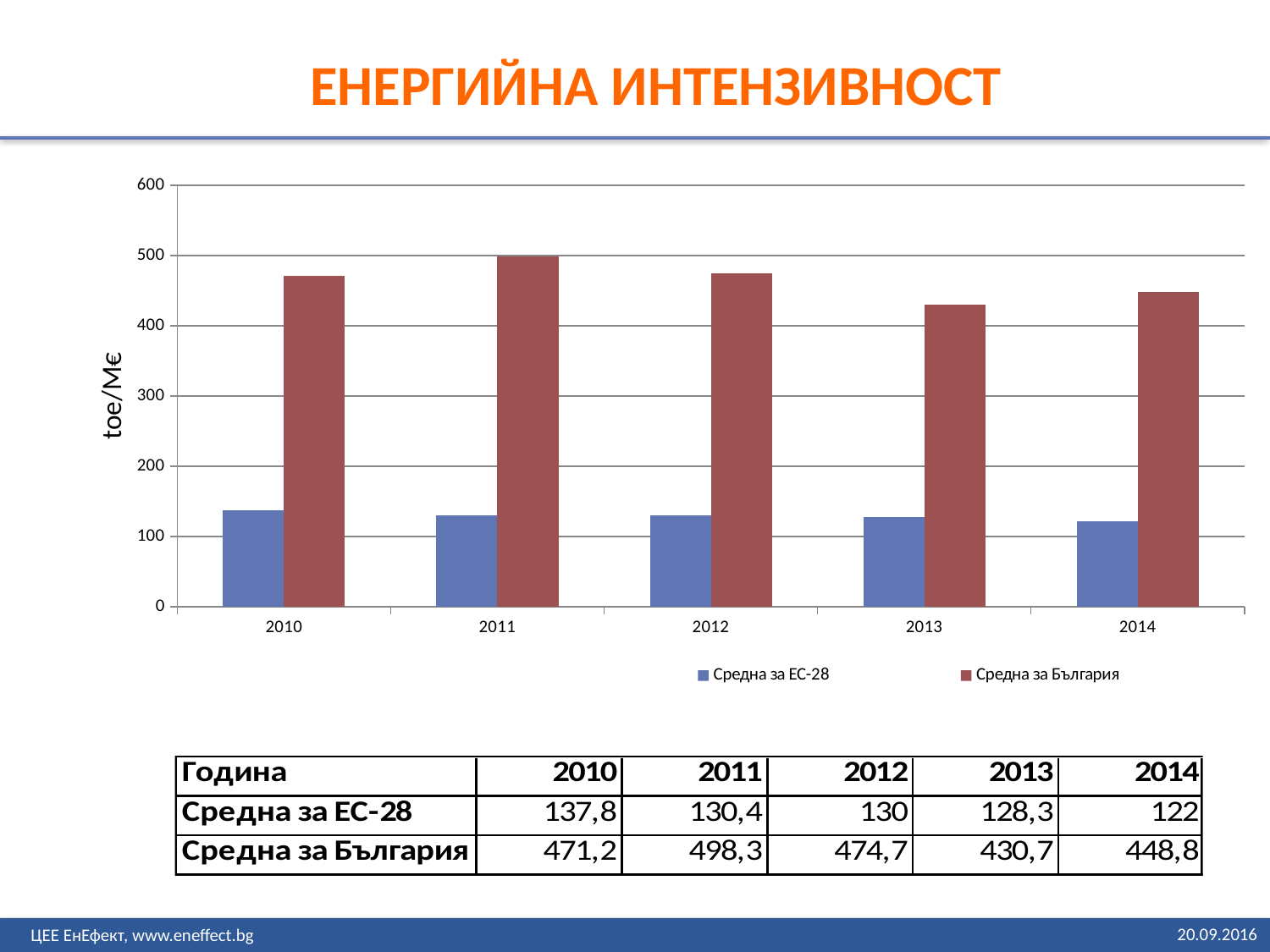
What is the difference between the Средна за България values for 2010 and 2014? 22,4 How many years are shown on the x axis of the chart? 5 How many series does the legend list? 2 In which year is the value for Средна за България highest? 2011 What is the value for Средна за ЕС-28 in 2014? 122 Does the value for Средна за ЕС-28 rise or fall from 2010 to 2014? fall What is the difference between Средна за България and Средна за ЕС-28 in 2011? 367,9 In which year is the value for Средна за България lowest? 2013 In which year is the value for Средна за ЕС-28 highest? 2010 Is the value for Средна за България in 2013 greater or less than 400? greater What is the value for Средна за България in 2011? 498,3 Which is larger in 2013: Средна за България or Средна за ЕС-28? Средна за България